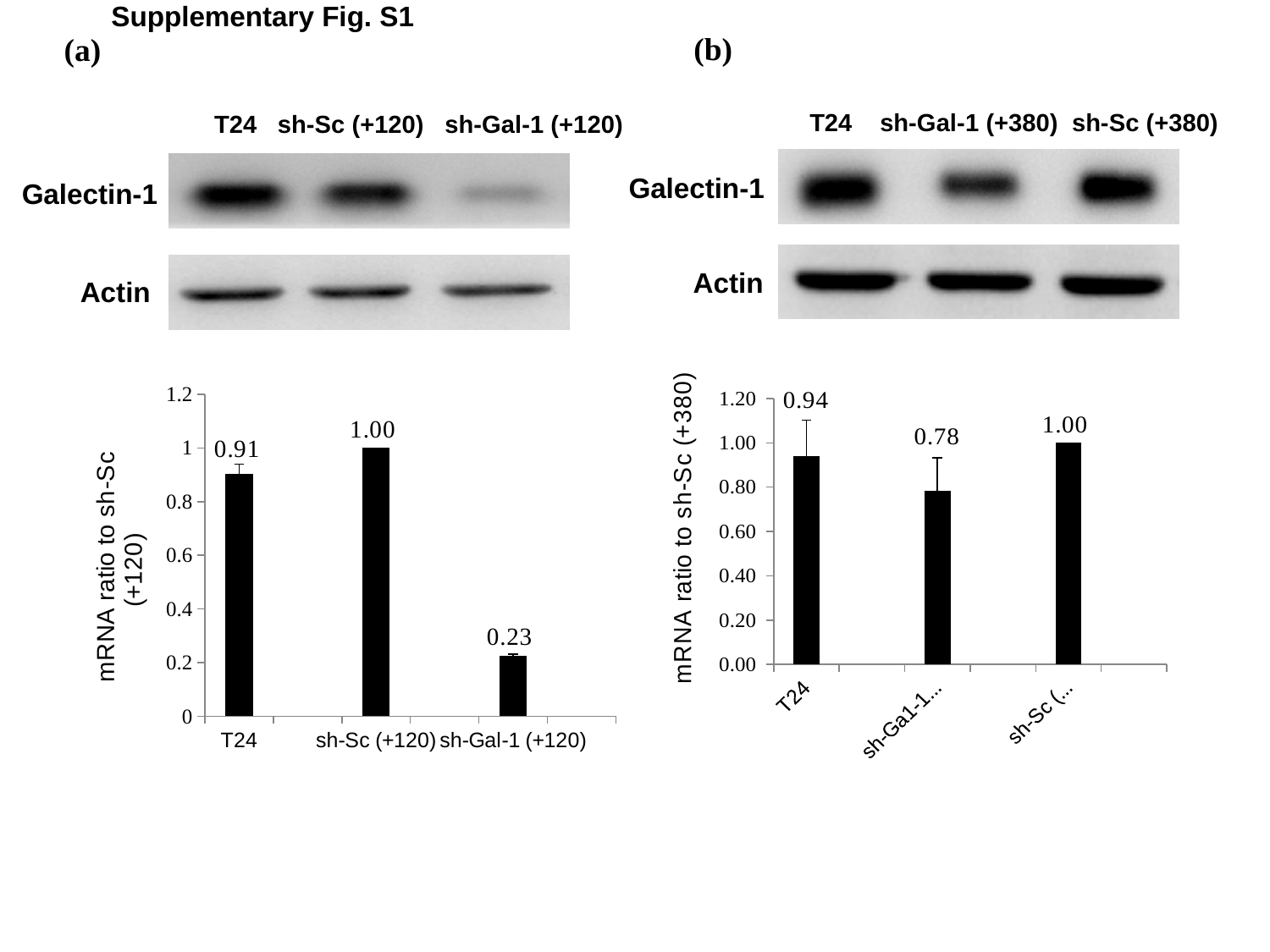
What is the y-axis label of the right chart (panel b)? mRNA ratio to sh-Sc (+380) In the right chart (panel b), what is the difference between the third bar (1.00) and the second bar (0.78)? 0.22 In the right chart (panel b), which bar has the lowest value? The second bar (sh-Gal-1) In the left chart (panel a), which category has the lowest value? sh-Gal-1 (+120) In the right chart (panel b), what is the value for T24? 0.94 In the left chart (panel a), what is the difference between the values for sh-Sc (+120) and sh-Gal-1 (+120)? 0.77 In the left chart (panel a), which category has the highest value? sh-Sc (+120) In the left chart (panel a), what is the value for T24? 0.91 In the left chart (panel a), what is the mRNA ratio value for sh-Gal-1 (+120)? 0.23 In the left chart (panel a), how many bars are plotted? 3 What type of chart is shown in panel (a)? Bar chart In the right chart (panel b), what is the value of the second bar (sh-Gal-1)? 0.78